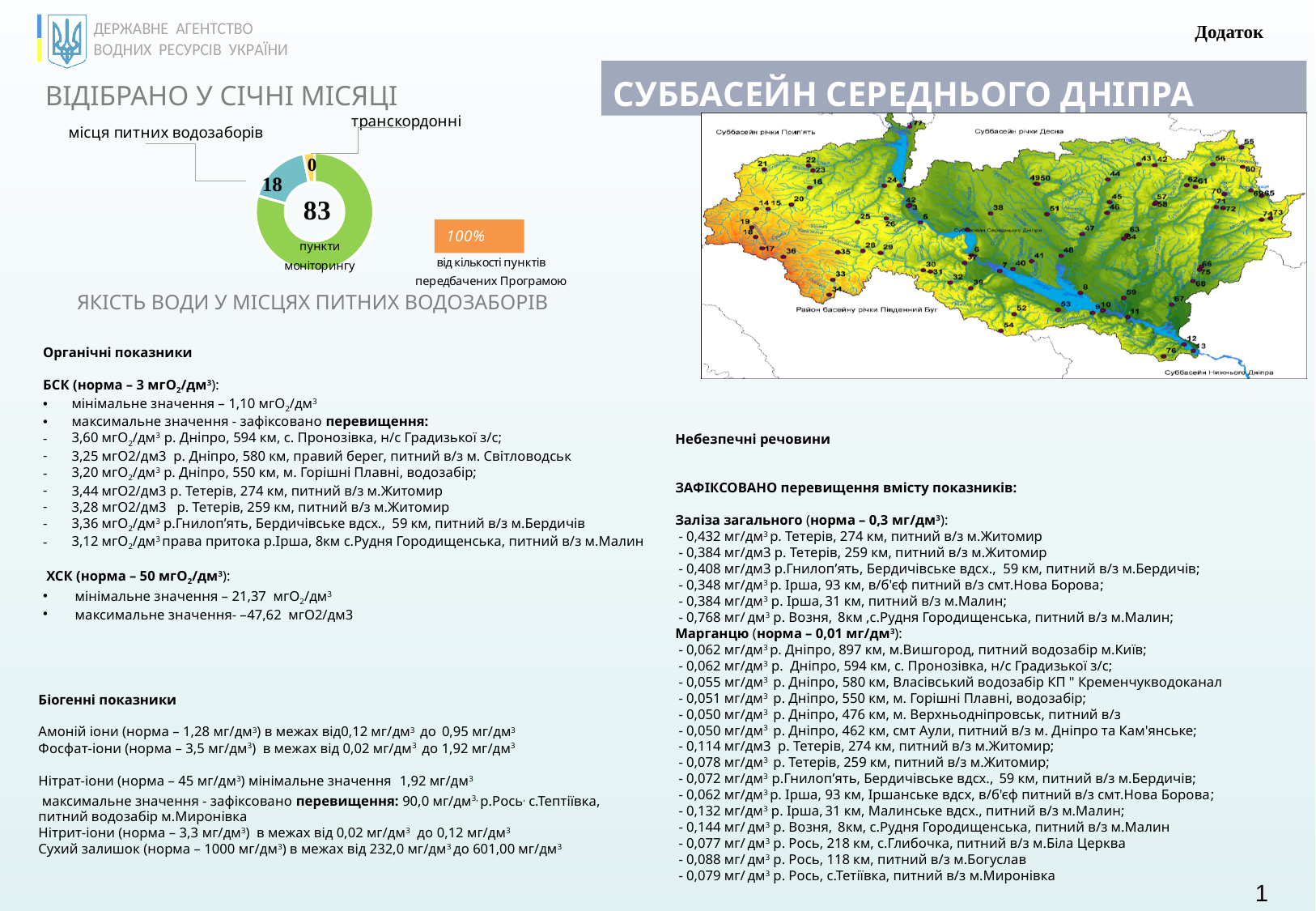
In the doughnut chart, what value is shown for "місця питних водозаборів"? 18 How many labelled categories does the doughnut chart show? 3 Which category in the doughnut chart has the lowest value? транскордонні What is the title above the doughnut chart? ВІДІБРАНО У СІЧНІ МІСЯЦІ In the doughnut chart, what value is shown for "транскордонні"? 0 In the doughnut chart, which is larger: the value for "місця питних водозаборів" or the value for "транскордонні"? місця питних водозаборів Which category in the doughnut chart has the highest value? пункти моніторингу What kind of chart is shown under the heading "ВІДІБРАНО У СІЧНІ МІСЯЦІ"? Doughnut (pie) chart What is the difference between the value for "пункти моніторингу" (83) and the value for "місця питних водозаборів" (18) in the doughnut chart? 65 What number is printed in the centre of the doughnut chart for "пункти моніторингу"? 83 What percentage is shown in the orange box next to the doughnut chart? 100%